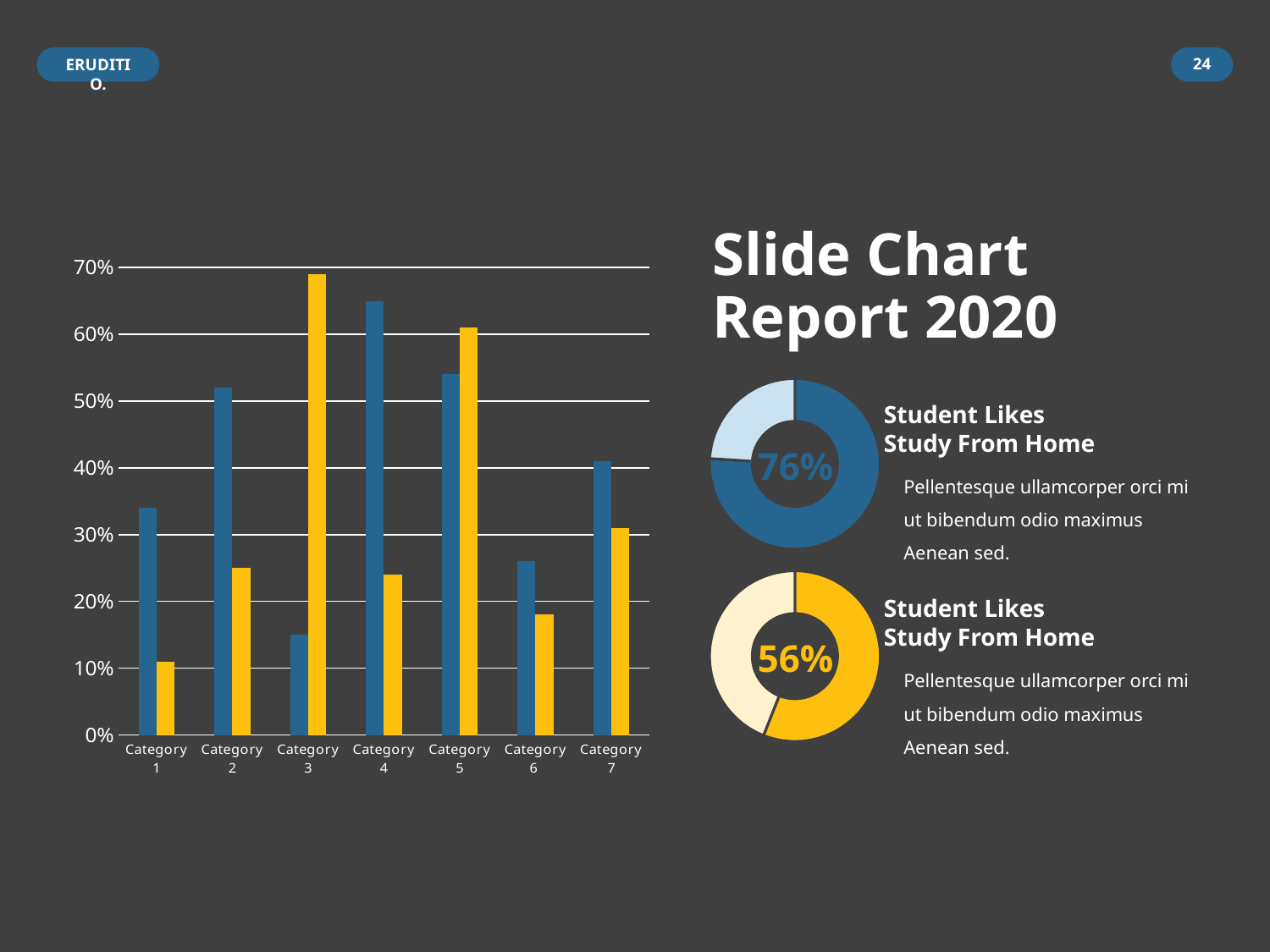
On the bar chart on the left of the slide, which category has the shortest yellow bar? Category 1 On the bar chart on the left of the slide, which is taller for Category 5, the blue bar or the yellow bar? the yellow bar On the bar chart on the left of the slide, which category has the shortest blue bar? Category 3 On the bar chart on the left of the slide, is the blue bar for Category 2 greater or less than 50%? greater On the bar chart on the left of the slide, what kind of chart is it? bar chart On the bar chart on the left of the slide, is the yellow bar for Category 6 greater or less than 20%? less On the bar chart on the left of the slide, which category has the tallest blue bar? Category 4 On the lower donut chart next to the second 'Student Likes Study From Home' heading, what percentage is shown in the centre? 56% On the bar chart on the left of the slide, which category has the tallest yellow bar? Category 3 On the upper donut chart next to the first 'Student Likes Study From Home' heading, what percentage is shown in the centre? 76% On the bar chart on the left of the slide, how many categories are shown on the x axis? 7